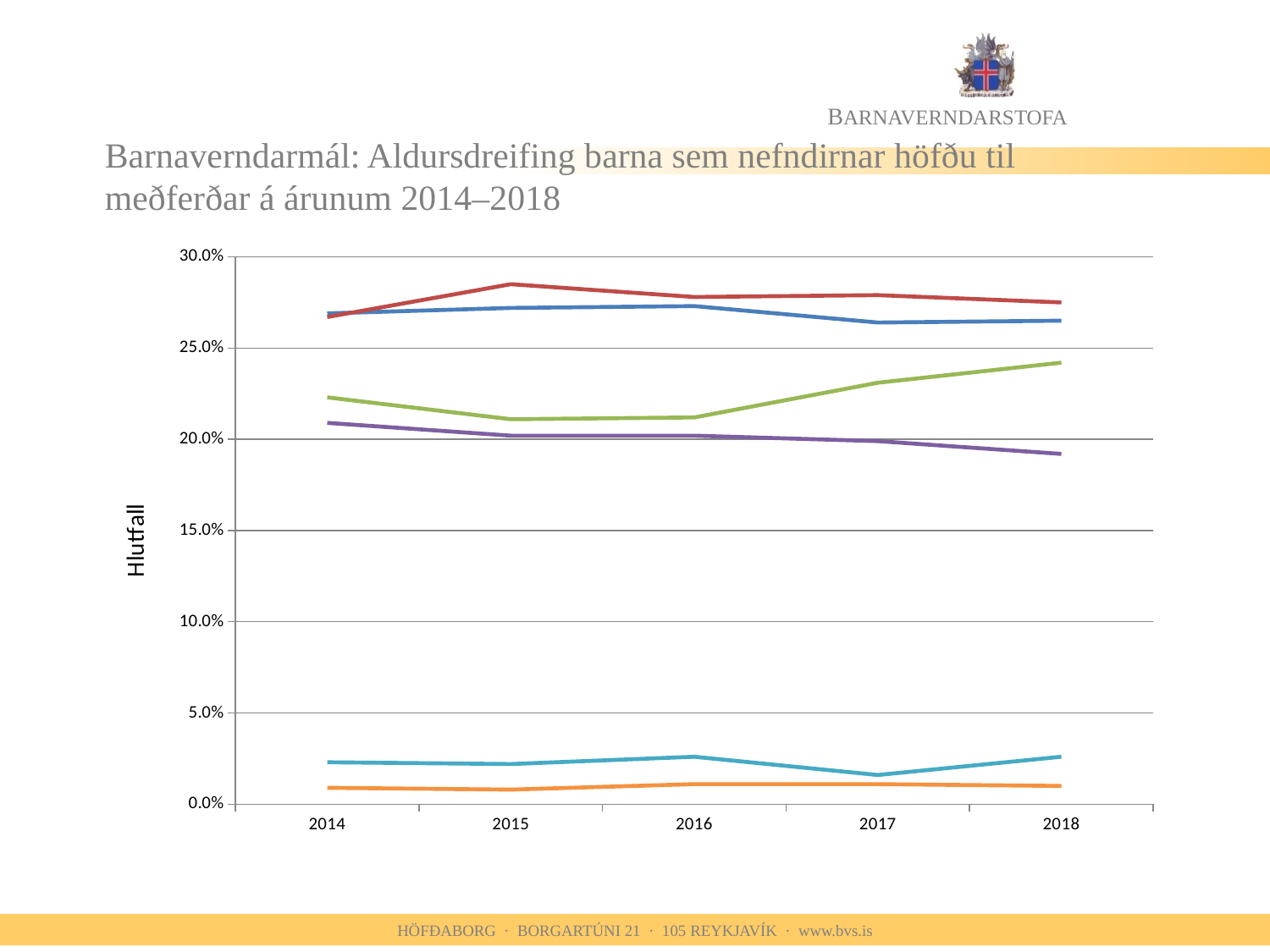
What kind of chart is shown on the slide? line chart Does the green line rise or fall between 2016 and 2018? rise Which line has the highest value in 2015? the red line Is the value of the red line in 2015 greater or less than 25.0%? greater What is the first year shown on the x axis of the chart? 2014 How many lines are plotted on the chart? 6 Is the value of the orange line in 2016 greater or less than 5.0%? less Is the value of the green line in 2018 greater or less than 20.0%? greater How many years are shown along the x axis of the chart? 5 Does the purple line rise or fall between 2014 and 2018? fall What is the label on the vertical axis of the chart? Hlutfall